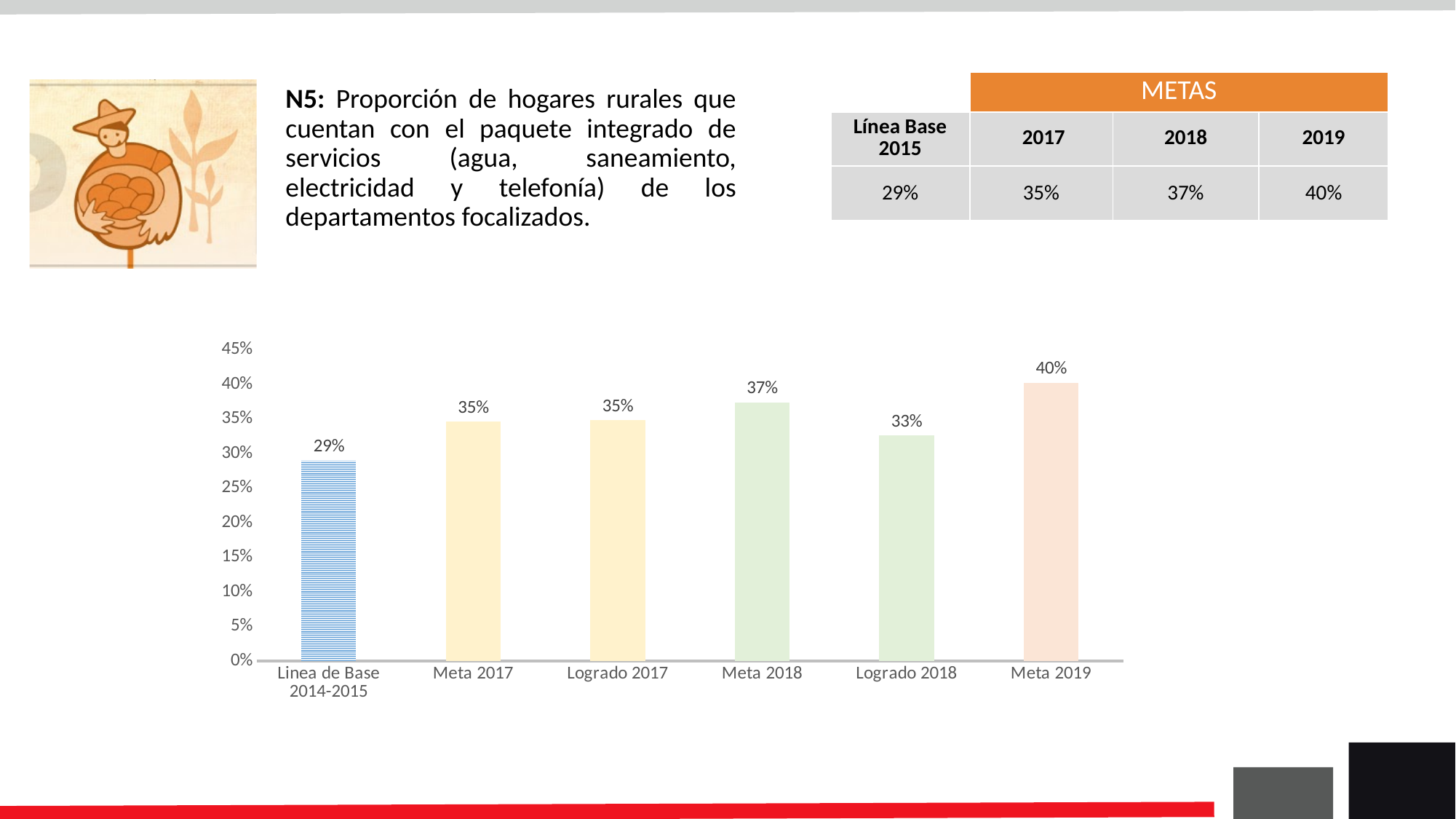
What is the value for Meta 2018? 37% Which is larger, Logrado 2018 or Meta 2018? Meta 2018 What kind of chart is shown on the slide? bar chart Is the value for Logrado 2017 greater or less than 30%? greater What is the value for Meta 2019? 40% What is the value for Logrado 2018? 33% How many categories are shown on the x axis? 6 Which category has the highest value? Meta 2019 What is the difference between Meta 2018 and Logrado 2018? 4% What is the difference between Meta 2019 and Linea de Base 2014-2015? 11% What is the value for Linea de Base 2014-2015? 29% Which category has the lowest value? Linea de Base 2014-2015